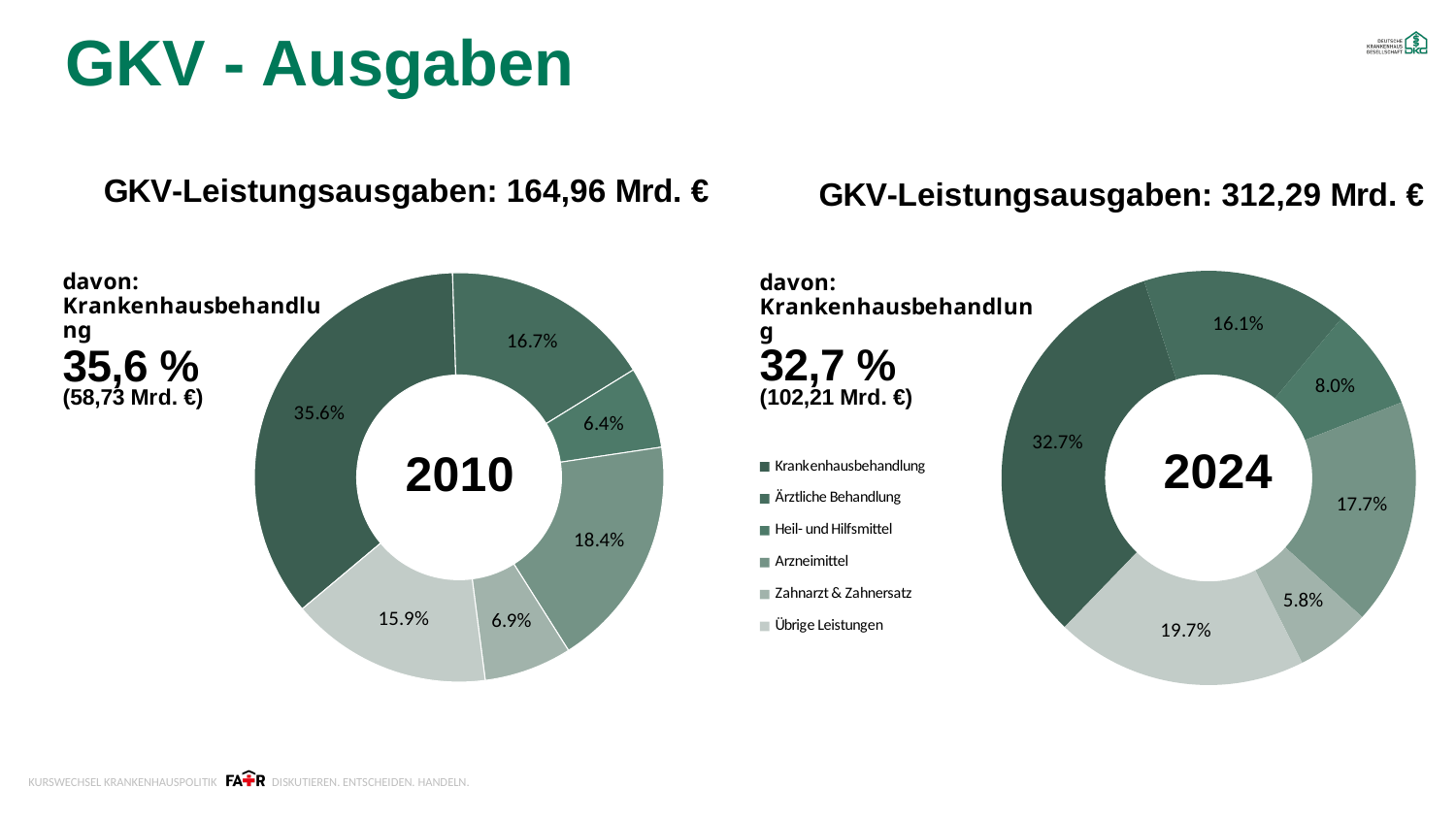
In the 2024 chart, what share of GKV-Leistungsausgaben is Krankenhausbehandlung? 32.7% Which is larger: the Krankenhausbehandlung share in 2010 or in 2024? 2010 In the 2024 chart, what is the smallest slice value shown? 5.8% How many slices does the 2024 chart have? 6 What kind of chart is used for the 2010 data? Donut (pie) chart In the 2024 chart, which category has the largest share? Krankenhausbehandlung How many entries does the legend list? 6 In the 2010 chart, which category has the largest share? Krankenhausbehandlung In the 2010 chart, what is the smallest slice value shown? 6.4% In the 2010 chart, what share of GKV-Leistungsausgaben is Krankenhausbehandlung? 35.6% What is the difference between the Krankenhausbehandlung share in 2010 and in 2024? 2.9 percentage points What total GKV-Leistungsausgaben is given above the 2024 chart? 312,29 Mrd. €